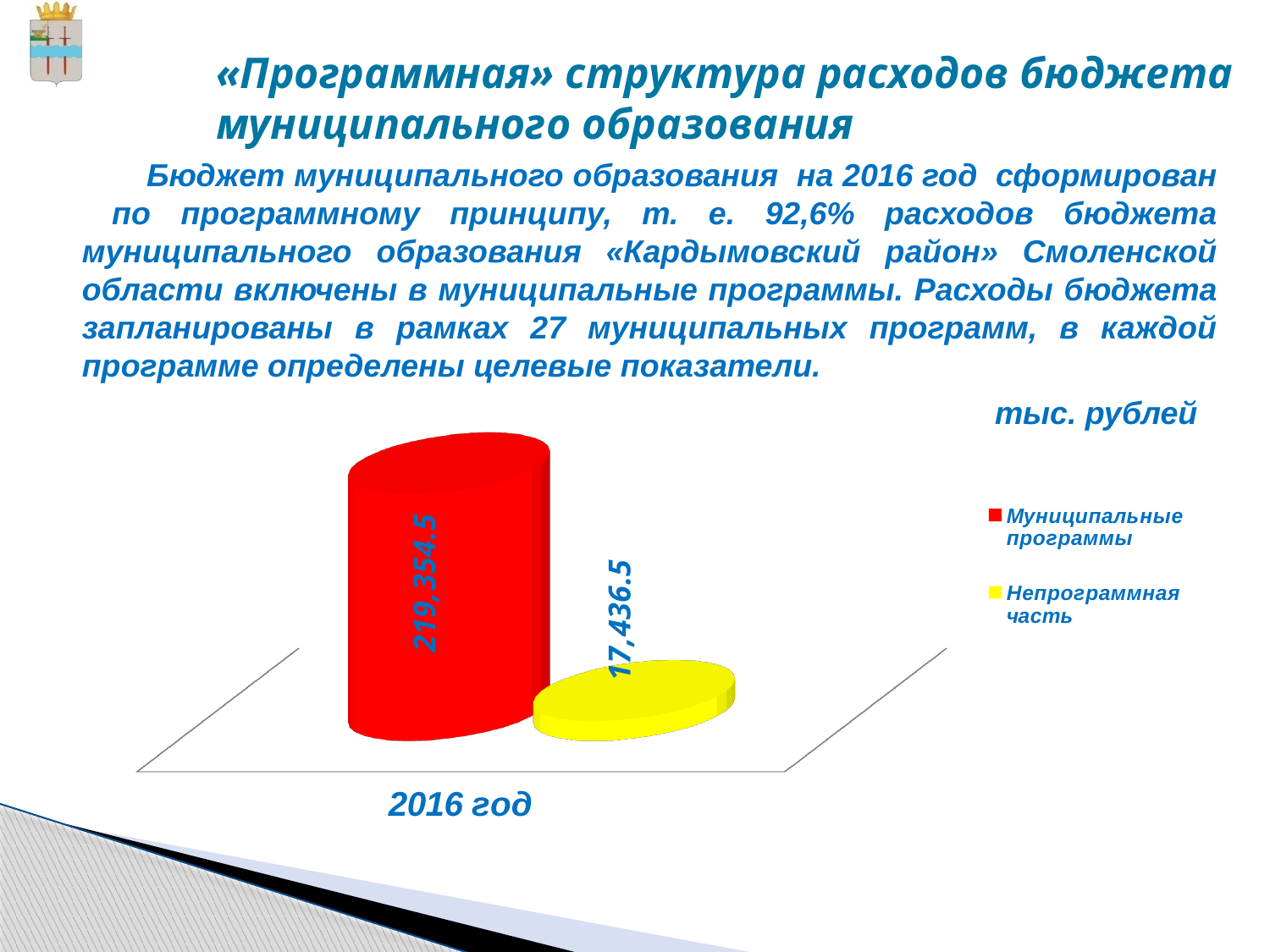
How many categories are shown on the x axis? 1 How many series does the legend list? 2 What is the value for Муниципальные программы in 2016 год? 219,354.5 What is the difference between the values for Муниципальные программы and Непрограммная часть? 201,918 Is the value for Муниципальные программы larger or smaller than the value for Непрограммная часть? larger Which series has the higher value in 2016 год? Муниципальные программы What is the value for Непрограммная часть in 2016 год? 17,436.5 What is the combined total of Муниципальные программы and Непрограммная часть for 2016 год? 236,791 Which series has the lower value in 2016 год? Непрограммная часть What colour represents Непрограммная часть in the chart? yellow What kind of chart is shown on the slide? bar chart What unit is indicated above the chart? тыс. рублей